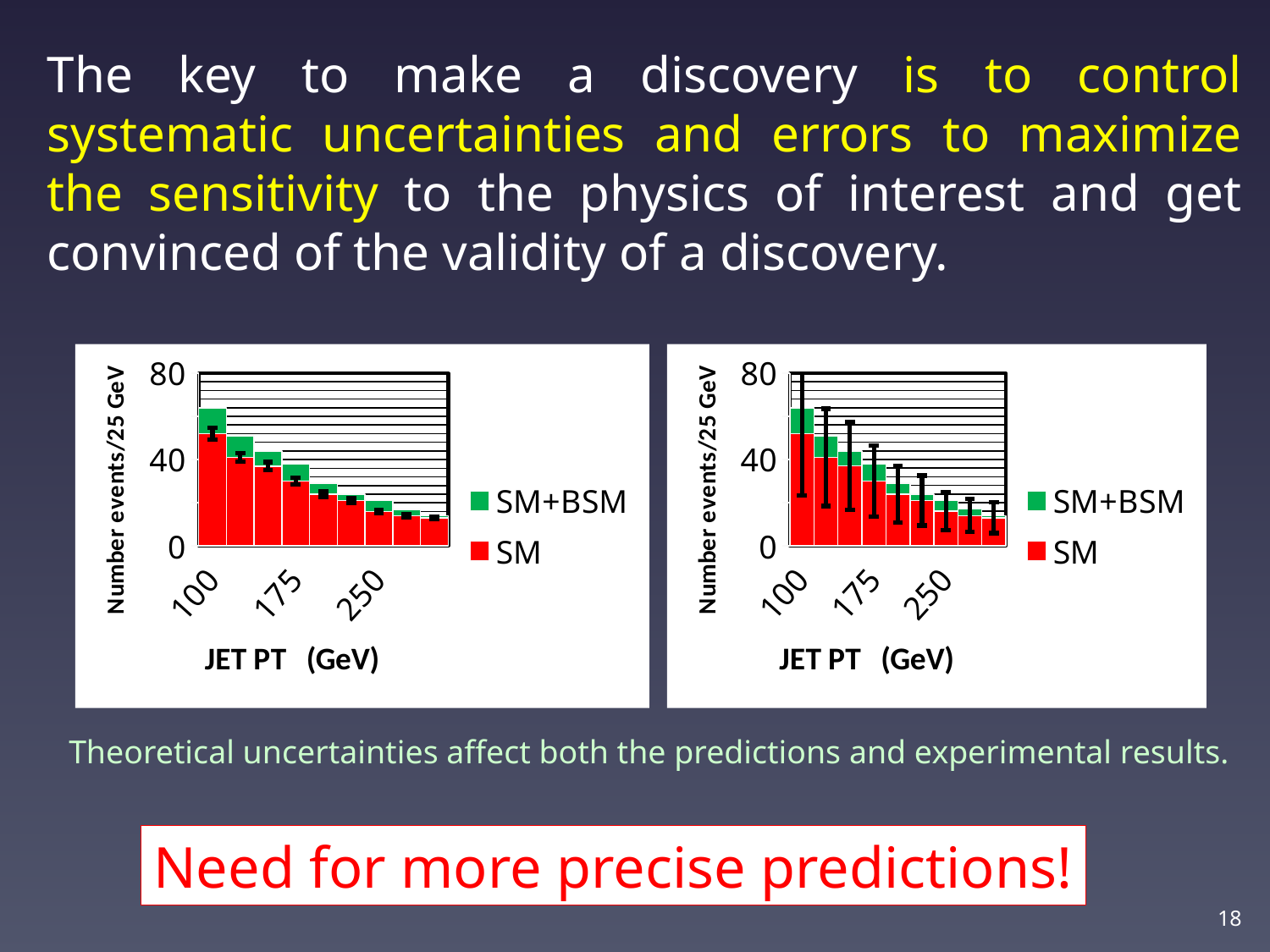
What kind of chart is the left chart? bar chart In the right chart, do the bar heights rise or fall as JET PT increases? fall How many series does the legend of the left chart list? 2 In the left chart, which bar is taller: the one at 100 GeV or the one at 250 GeV? 100 GeV What is the x-axis title of the left chart? JET PT (GeV) In the right chart, which JET PT bin has the tallest bar? 100 In the left chart, do the bar heights rise or fall as JET PT increases? fall In the right chart, is the total height of the bar at 100 GeV greater or less than 80? less In the left chart, is the total height of the bar at 250 GeV greater or less than 40? less What kind of chart is the right chart? bar chart In the left chart, is the SM value for the bar at 100 GeV greater or less than 40? greater What are the two series named in the legend of the right chart? SM+BSM and SM